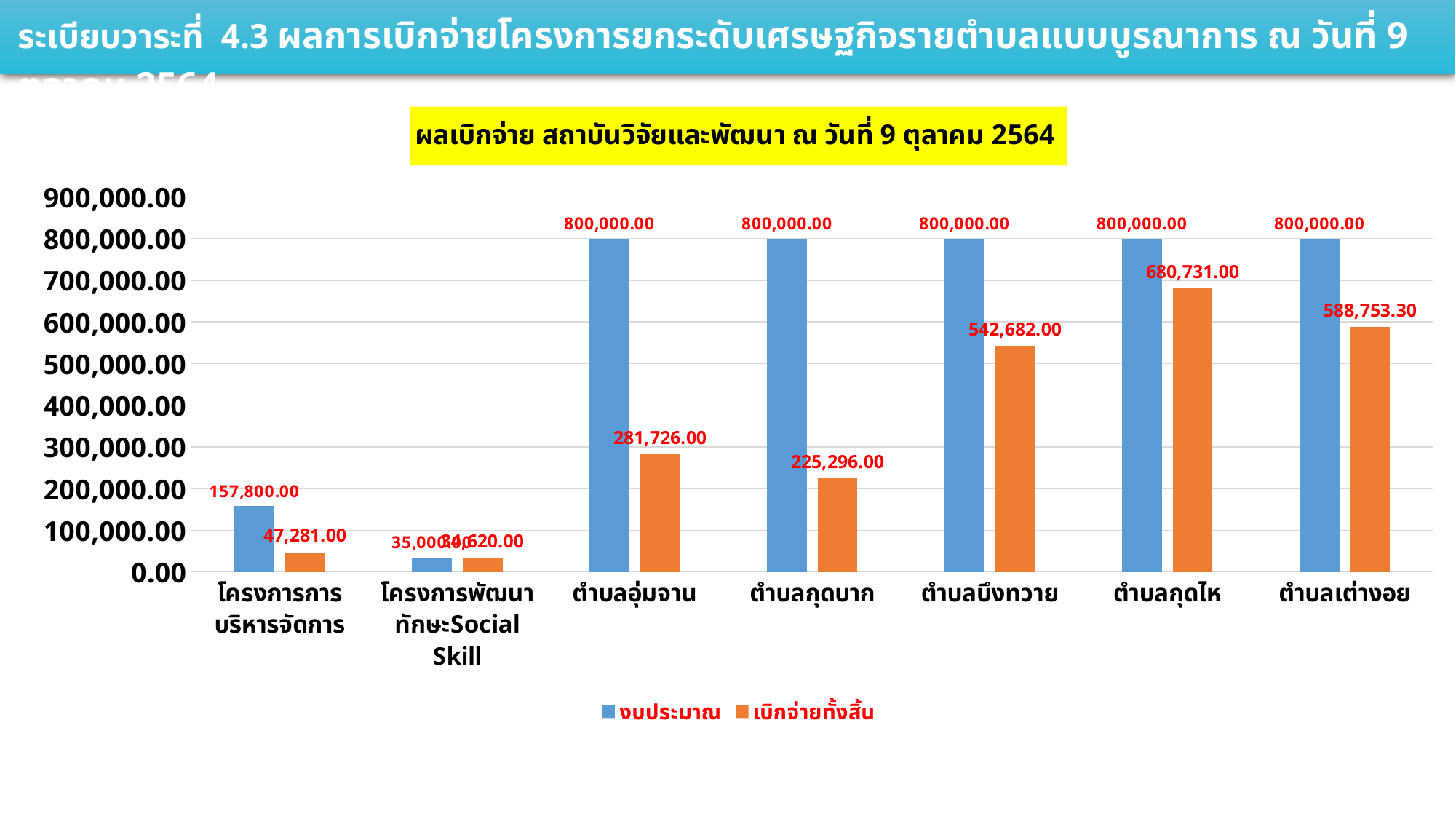
Is the เบิกจ่ายทั้งสิ้น value for ตำบลบึงทวาย greater or less than 500,000.00? greater What kind of chart is shown on the slide? bar chart Which category has the lowest งบประมาณ value? โครงการพัฒนาทักษะSocial Skill What is the เบิกจ่ายทั้งสิ้น value for ตำบลกุดบาก? 225,296.00 How many series does the legend list? 2 How many categories are shown on the x axis? 7 What is the งบประมาณ value for โครงการการบริหารจัดการ? 157,800.00 Which is larger, the เบิกจ่ายทั้งสิ้น value for ตำบลอุ่มจาน or for ตำบลกุดบาก? ตำบลอุ่มจาน What is the เบิกจ่ายทั้งสิ้น value for ตำบลเต่างอย? 588,753.30 What is the เบิกจ่ายทั้งสิ้น value for ตำบลกุดไห? 680,731.00 What is the difference between งบประมาณ and เบิกจ่ายทั้งสิ้น for ตำบลบึงทวาย? 257,318.00 Which category has the highest เบิกจ่ายทั้งสิ้น value? ตำบลกุดไห